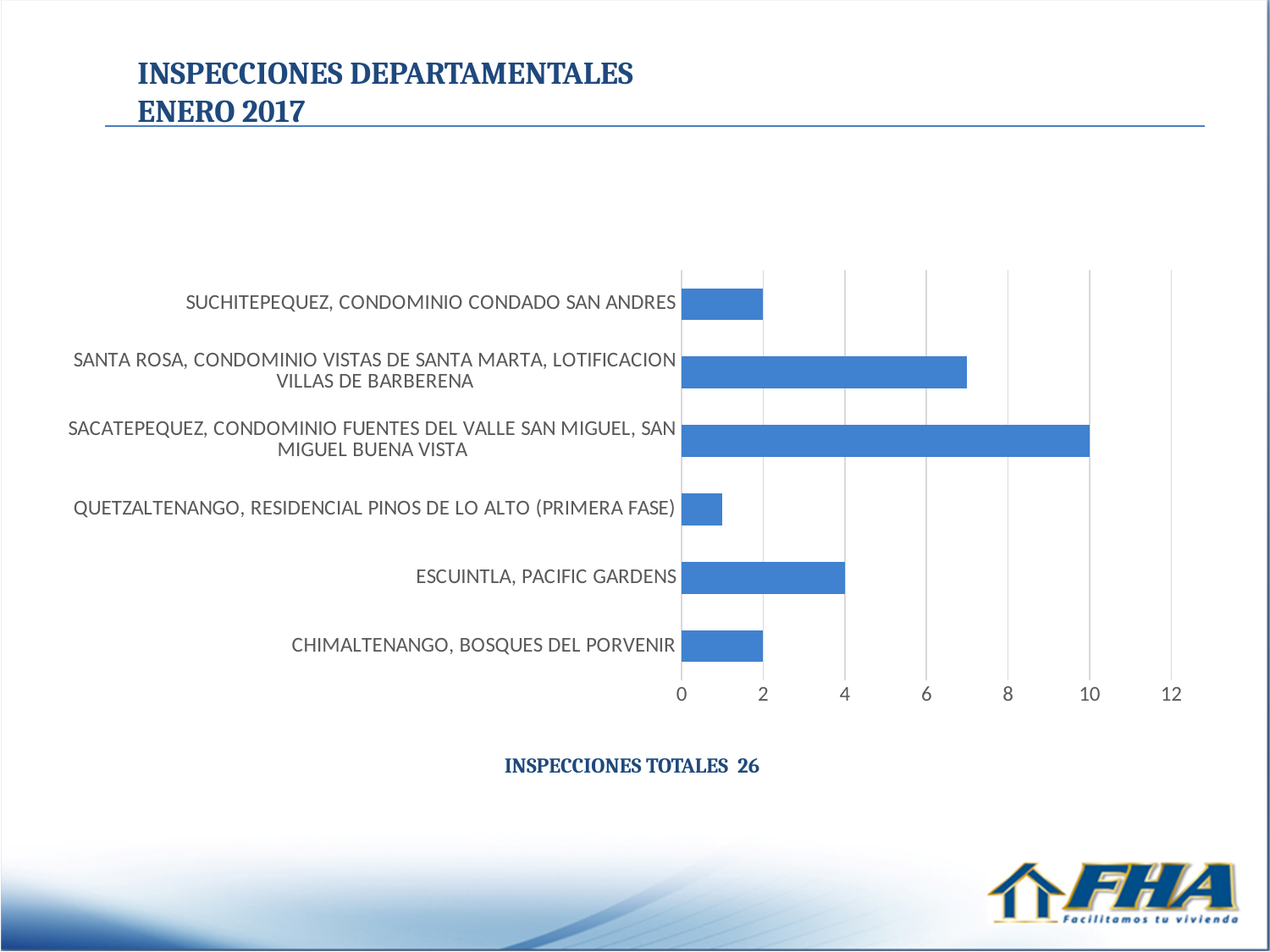
Which is larger, the value for ESCUINTLA, PACIFIC GARDENS or the value for SUCHITEPEQUEZ, CONDOMINIO CONDADO SAN ANDRES? ESCUINTLA, PACIFIC GARDENS Which category has the lowest value? QUETZALTENANGO, RESIDENCIAL PINOS DE LO ALTO (PRIMERA FASE) Is the value for QUETZALTENANGO, RESIDENCIAL PINOS DE LO ALTO (PRIMERA FASE) greater or less than 2? less What is the value for ESCUINTLA, PACIFIC GARDENS? 4 How many categories are shown in the chart? 6 Is the value for SANTA ROSA, CONDOMINIO VISTAS DE SANTA MARTA, LOTIFICACION VILLAS DE BARBERENA greater or less than 6? greater What is the value for SUCHITEPEQUEZ, CONDOMINIO CONDADO SAN ANDRES? 2 What kind of chart is shown on the slide? bar chart What is the difference between the values for SACATEPEQUEZ, CONDOMINIO FUENTES DEL VALLE SAN MIGUEL, SAN MIGUEL BUENA VISTA and ESCUINTLA, PACIFIC GARDENS? 6 What is the value for CHIMALTENANGO, BOSQUES DEL PORVENIR? 2 What is the value for SACATEPEQUEZ, CONDOMINIO FUENTES DEL VALLE SAN MIGUEL, SAN MIGUEL BUENA VISTA? 10 Which category has the highest value? SACATEPEQUEZ, CONDOMINIO FUENTES DEL VALLE SAN MIGUEL, SAN MIGUEL BUENA VISTA